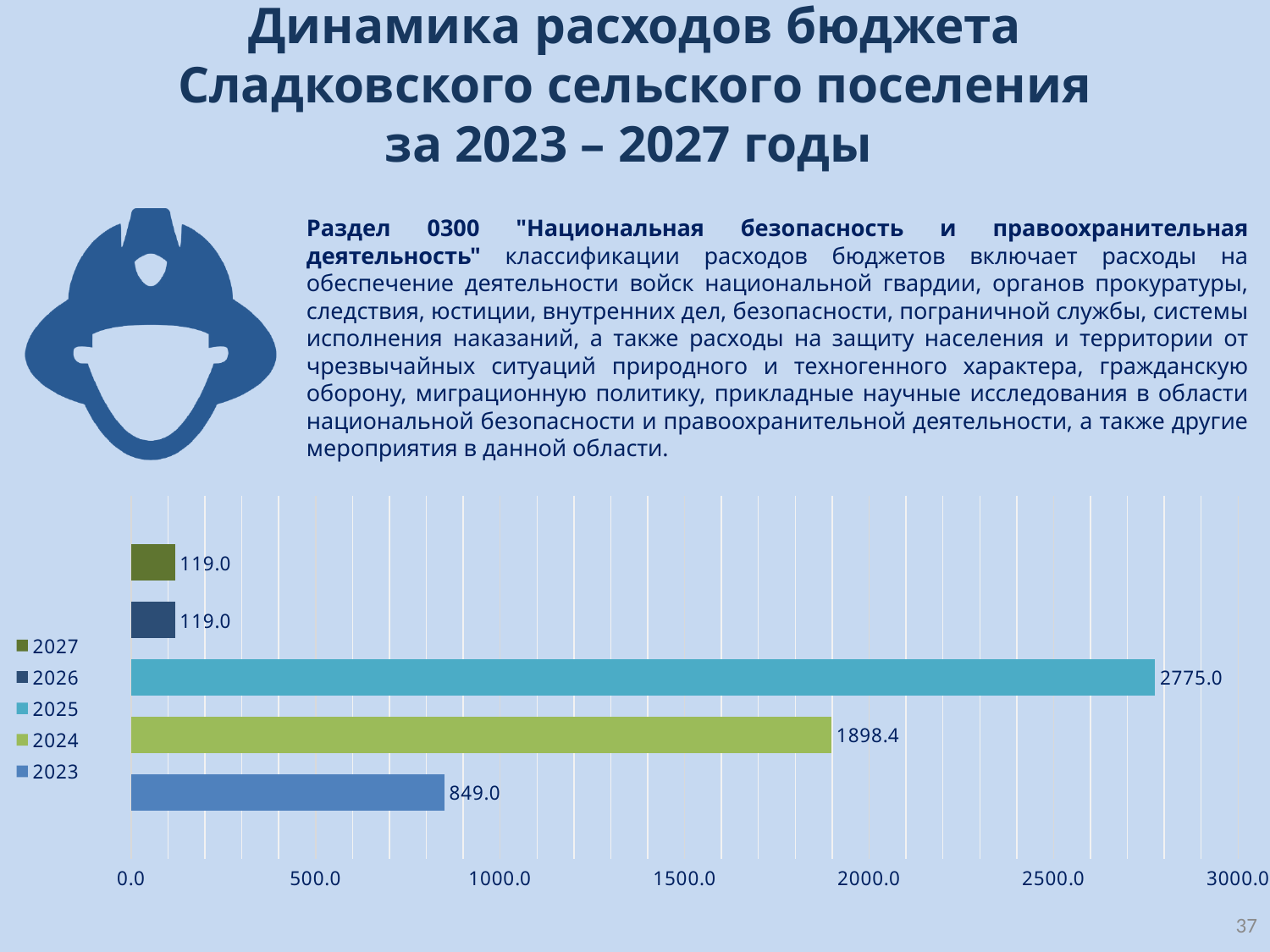
What is the value for 2023 in the bar chart? 849.0 Which year has the highest value in the bar chart? 2025 How many bars are plotted in the chart? 5 What is the difference between the values for 2024 and 2023? 1049.4 What kind of chart is shown on the slide? bar chart What is the value for 2024 in the bar chart? 1898.4 How many series does the legend list? 5 Which is larger, the value for 2024 or the value for 2023? 2024 What is the difference between the values for 2025 and 2024? 876.6 Is the value for 2023 greater or less than 1000.0? less What is the value for 2026 in the bar chart? 119.0 What is the value for 2025 in the bar chart? 2775.0